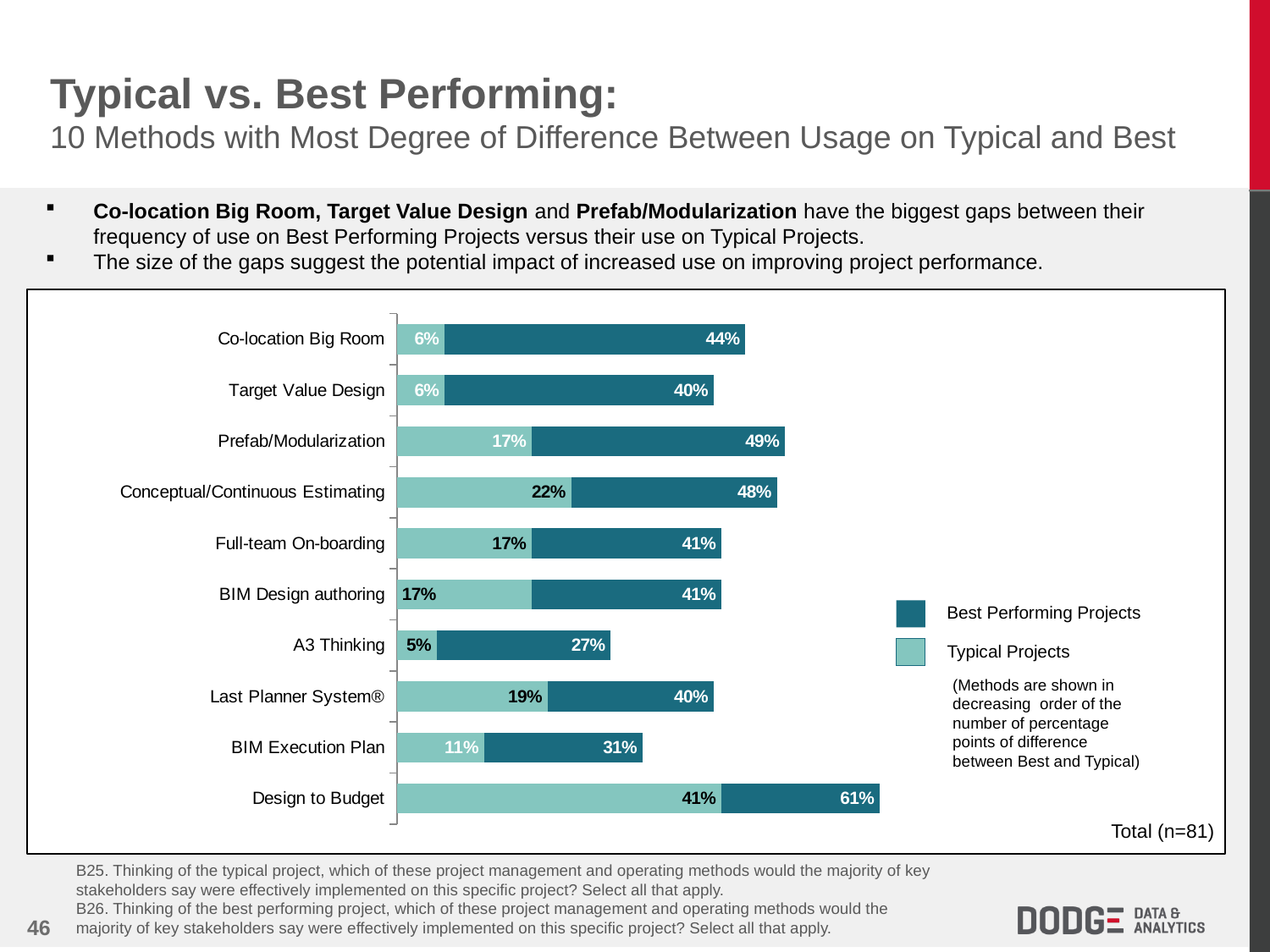
What is the difference in percentage points between Best Performing Projects and Typical Projects for Co-location Big Room? 38 What percentage of Typical Projects use Prefab/Modularization? 17% Which method has the highest Best Performing Projects value? Design to Budget What is the difference in percentage points between Best Performing Projects and Typical Projects for Design to Budget? 20 How many series does the legend list? 2 What is the Typical Projects value for Last Planner System®? 19% What percentage of Best Performing Projects use Co-location Big Room? 44% Which method has the lowest Typical Projects value? A3 Thinking How many methods are shown in the chart? 10 What is the Best Performing Projects value for Conceptual/Continuous Estimating? 48% Which is larger: the Best Performing Projects value for Prefab/Modularization or for Full-team On-boarding? Prefab/Modularization What type of chart is shown on the slide? Bar chart